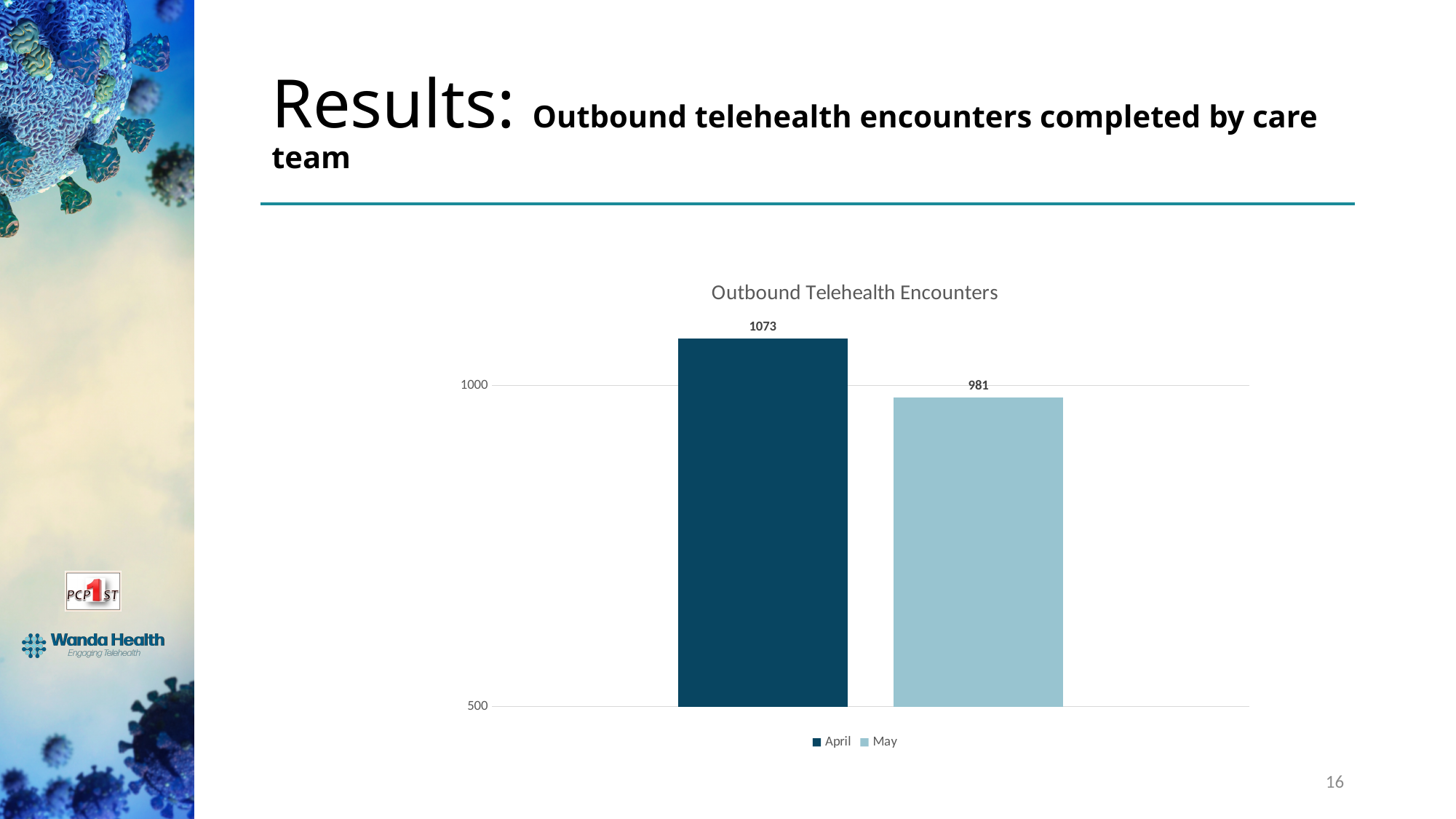
Is the value for May greater or less than 1000? less What is the value for April in the Outbound Telehealth Encounters chart? 1073 Do the values rise or fall from April to May? fall Which month has the lower number of outbound telehealth encounters? May How many series does the chart legend list? 2 Which month has the higher number of outbound telehealth encounters? April Is the value for April greater or less than 1000? greater What is the title of the chart on the slide? Outbound Telehealth Encounters What is the difference between the April and May values in the chart? 92 Which series is shown in the darker blue colour in the chart? April What is the value for May in the Outbound Telehealth Encounters chart? 981 What kind of chart is shown on the slide? bar chart